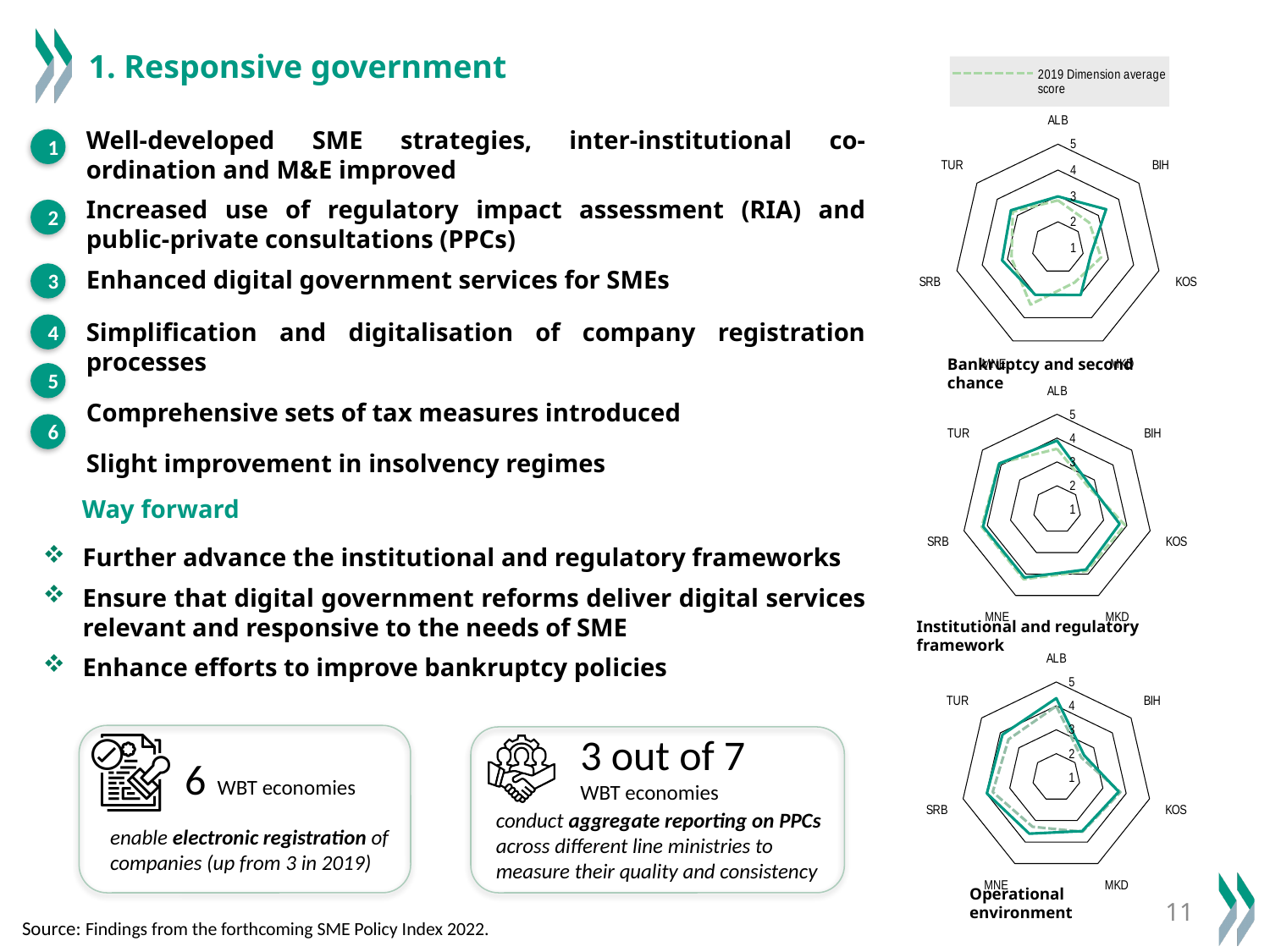
What is the highest value shown on the axis scale of the radar charts? 5 How many entries does the legend above the top radar chart list? 1 How many economies (axes) are plotted on the top radar chart? 7 On the bottom radar chart, is the solid-line value for TUR greater or less than 3? greater On the bottom radar chart, is the solid-line value for ALB greater or less than 3? greater On the middle radar chart, is the solid-line value for ALB greater or less than 3? greater What is the legend entry shown above the top radar chart? 2019 Dimension average score What kind of chart is the top chart on the right side of the slide? radar chart Which economy is plotted on the axis at the top of each radar chart? ALB